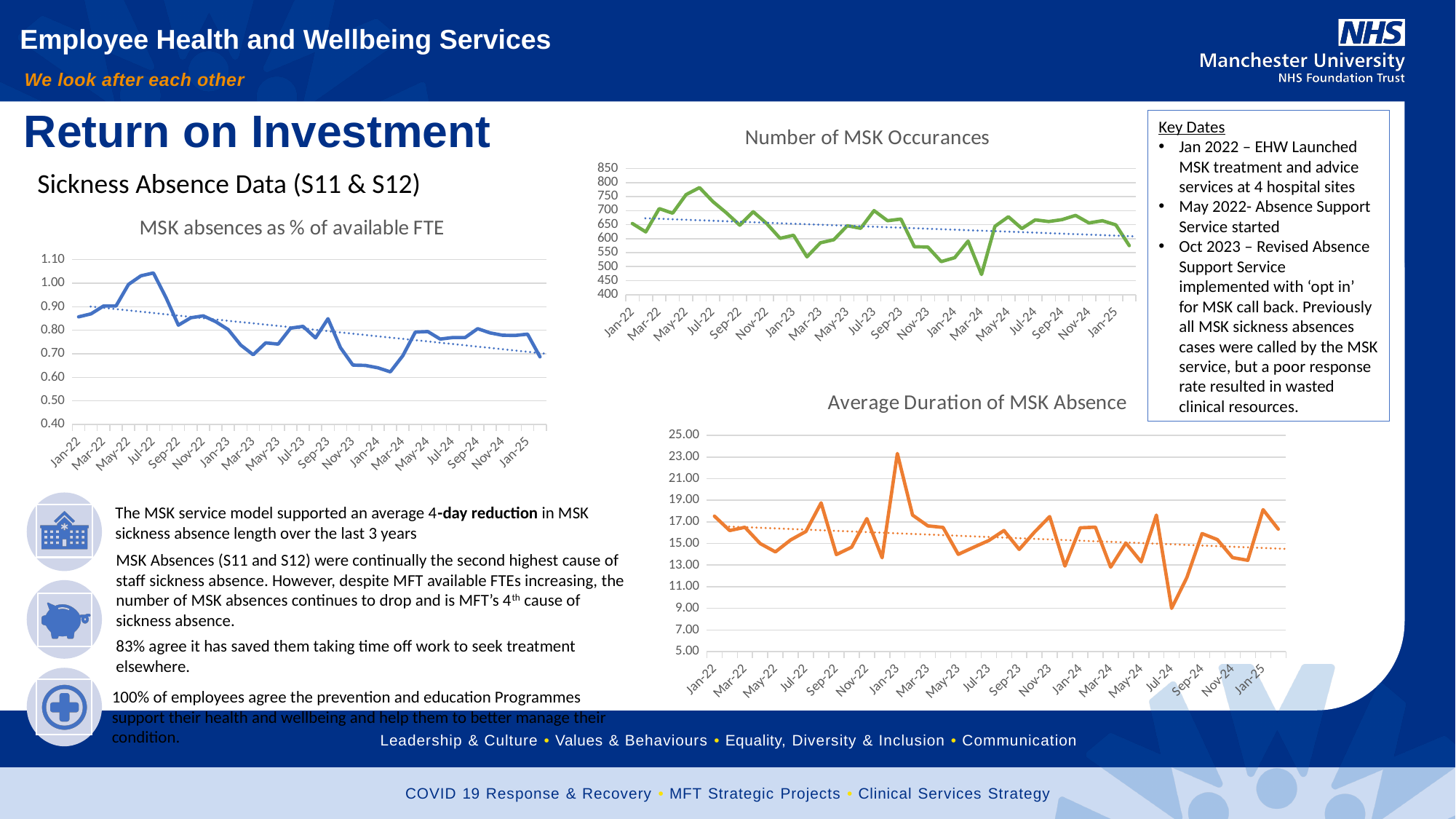
In the 'Number of MSK Occurances' chart, is the value for Jan-22 greater or less than 600? greater What kind of chart is the 'Number of MSK Occurances' chart? line chart In the 'Average Duration of MSK Absence' chart, which month has the highest value? Jan-23 In the 'Average Duration of MSK Absence' chart, is the value for Jan-23 greater or less than 21.00? greater In the 'Number of MSK Occurances' chart, which month has the lowest value? Mar-24 In the 'MSK absences as % of available FTE' chart, which month has the highest value? Jul-22 In the 'Number of MSK Occurances' chart, does the dotted trend line rise or fall from Jan-22 to Jan-25? fall In the 'Average Duration of MSK Absence' chart, is the value for Jul-24 greater or less than 11.00? less What colour is the data line in the 'Average Duration of MSK Absence' chart? orange How many charts are shown on the slide? 3